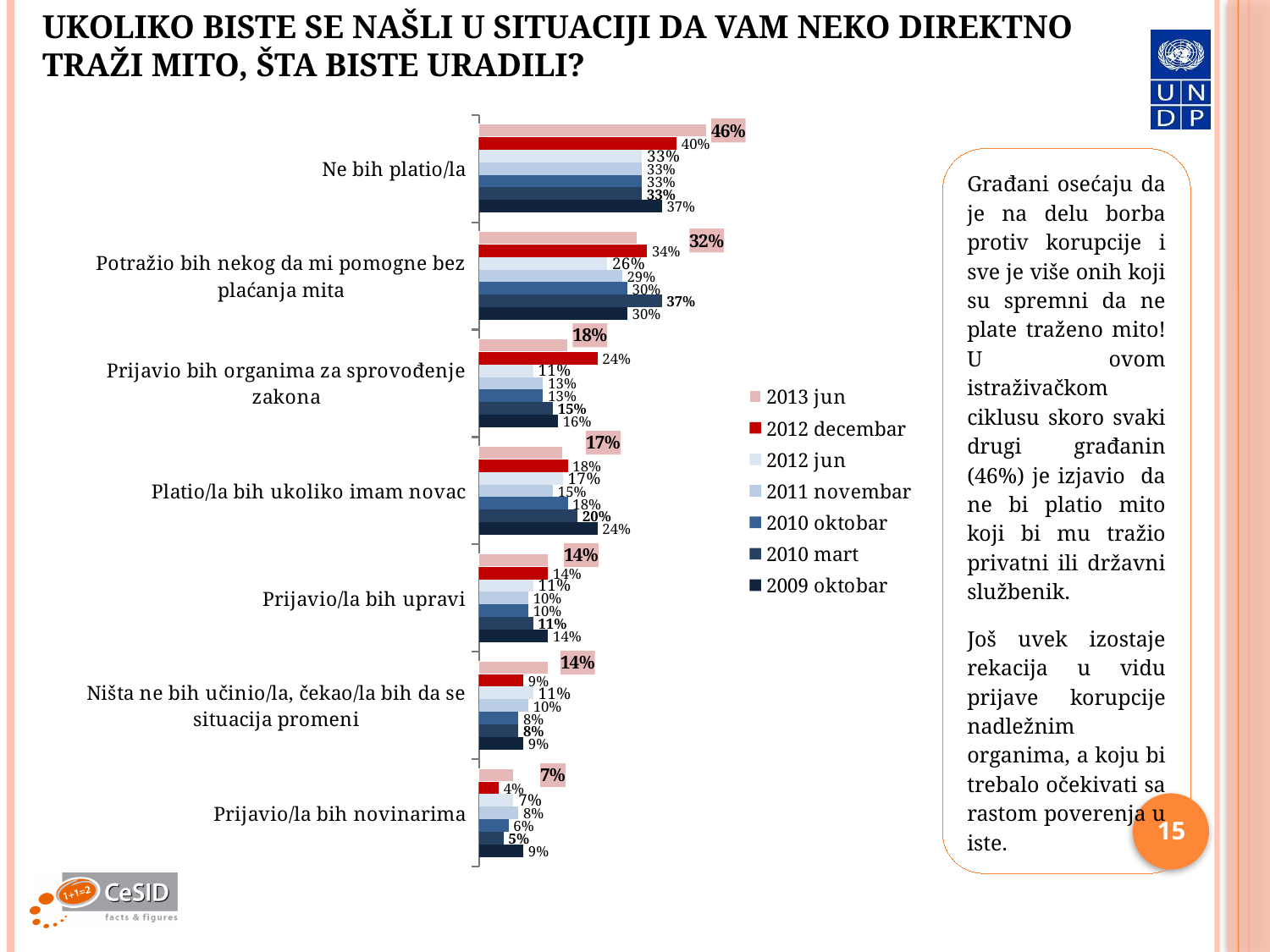
What is the difference between the 2013 jun and 2012 decembar values for "Ne bih platio/la"? 6% Which category has the lowest value in the 2012 decembar series? Prijavio/la bih novinarima What kind of chart is shown on the slide? Bar chart Which category has the highest value in the 2013 jun series? Ne bih platio/la For "Platio/la bih ukoliko imam novac", which is larger: the 2009 oktobar value or the 2013 jun value? 2009 oktobar What is the value for "Potražio bih nekog da mi pomogne bez plaćanja mita" in the 2010 mart series? 37% How many categories are shown on the chart? 7 What is the value for "Prijavio/la bih novinarima" in the 2009 oktobar series? 9% Which series is shown in the lightest pink colour in the legend? 2013 jun What is the value for "Prijavio bih organima za sprovođenje zakona" in the 2012 decembar series? 24% How many series does the legend list? 7 What is the value for "Ne bih platio/la" in the 2013 jun series? 46%